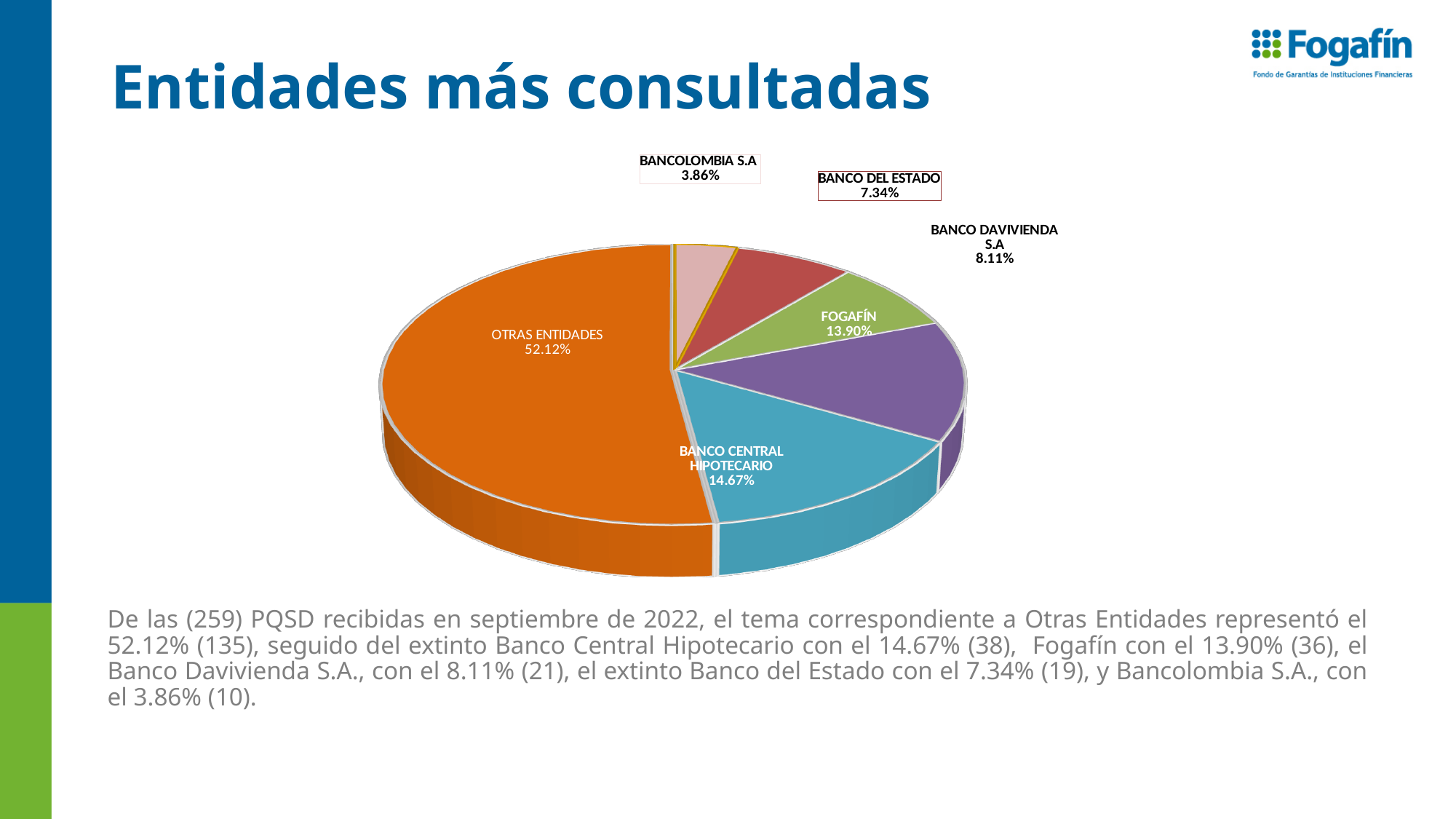
What is the difference between the values for BANCO CENTRAL HIPOTECARIO and FOGAFÍN? 0.77% What is the value shown for BANCO DEL ESTADO? 7.34% Which category has the smallest slice of the pie? BANCOLOMBIA S.A What is the value shown for BANCOLOMBIA S.A? 3.86% What is the value shown for FOGAFÍN? 13.90% What is the value shown for BANCO DAVIVIENDA S.A? 8.11% What share of the pie does OTRAS ENTIDADES represent? 52.12% Which is larger, the value for BANCO DAVIVIENDA S.A or the value for BANCO DEL ESTADO? BANCO DAVIVIENDA S.A What is the value shown for BANCO CENTRAL HIPOTECARIO? 14.67% Which category has the largest slice of the pie? OTRAS ENTIDADES How many slices does the pie chart have? 6 What type of chart is shown on the slide? Pie chart